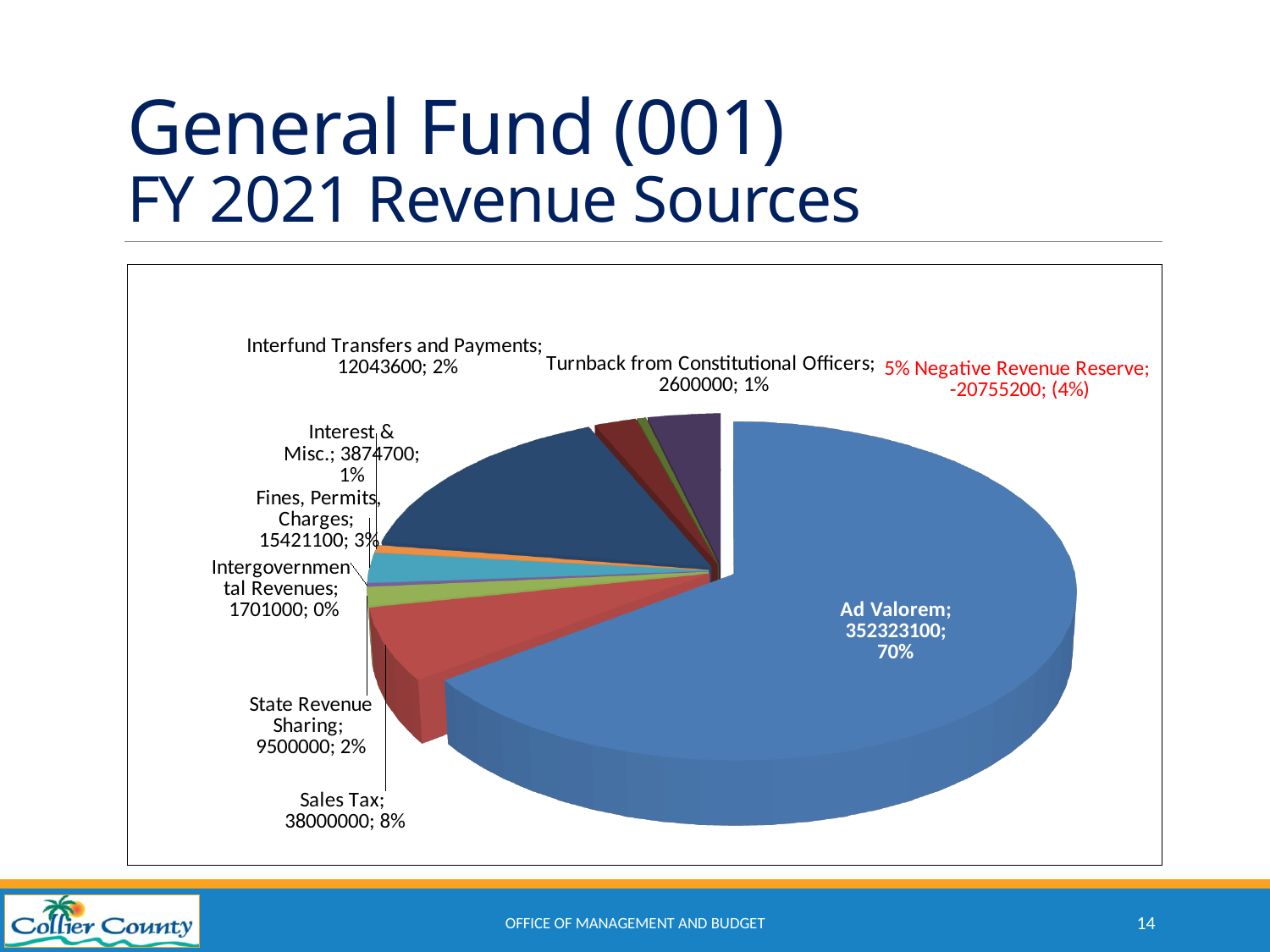
What is the value shown for Ad Valorem? 352323100 What is the value shown for Sales Tax? 38000000 Which revenue source has the smallest positive value? Intergovernmental Revenues What is the value shown for the 5% Negative Revenue Reserve? -20755200 What share of the pie does Sales Tax represent? 8% What is the value shown for Fines, Permits, Charges? 15421100 What share of the pie does Ad Valorem represent? 70% How many categories are labelled on the pie chart? 9 Which revenue source has the largest value? Ad Valorem What is the difference between the Sales Tax value and the State Revenue Sharing value? 28500000 What type of chart is shown on the slide? Pie chart Which is larger, State Revenue Sharing or Interfund Transfers and Payments? Interfund Transfers and Payments